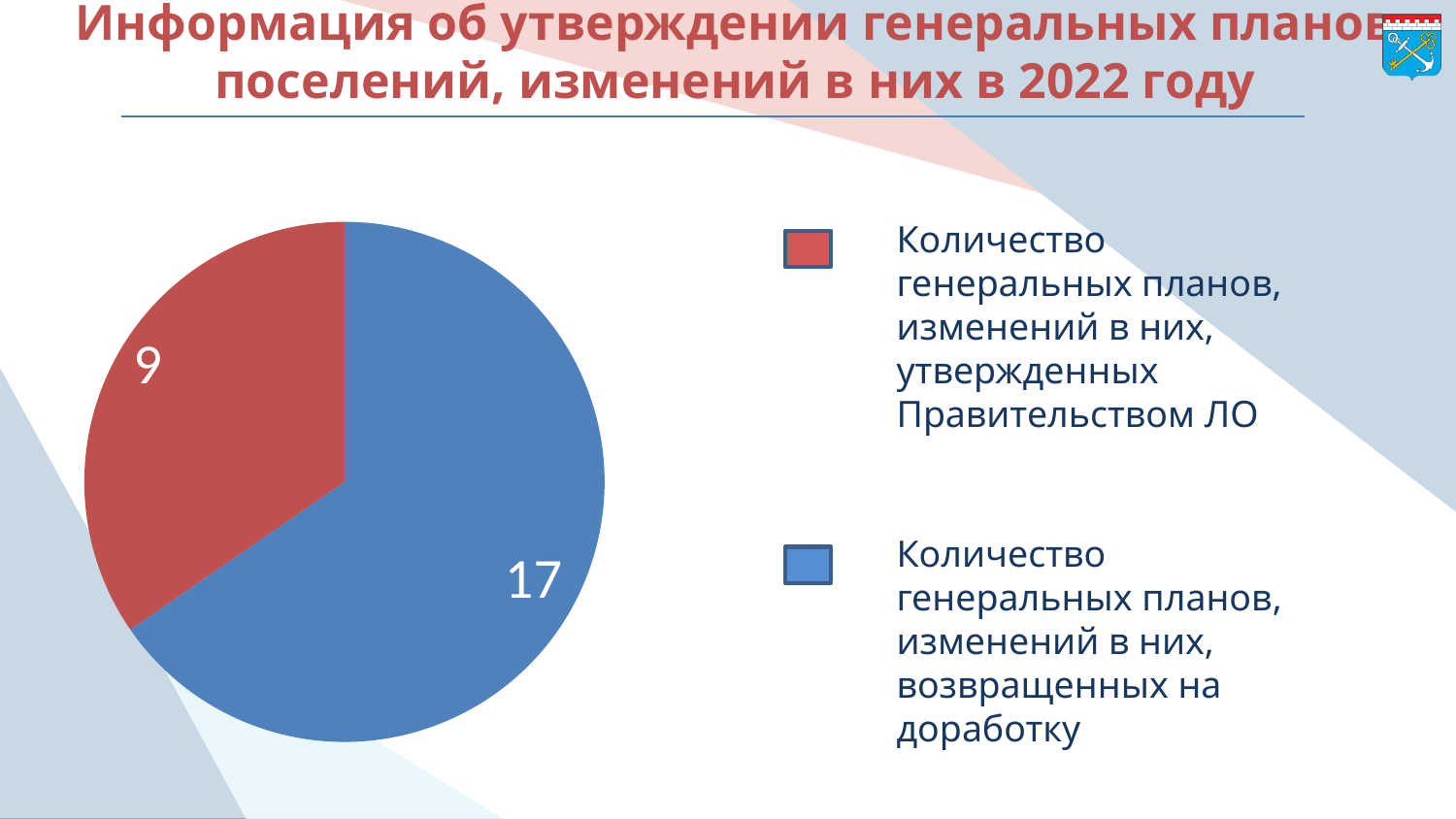
How many slices does the pie chart have? 2 What is the value for the number of general plans and amendments approved by the Government of Leningrad Oblast (Правительством ЛО)? 9 Which category has the smallest slice of the pie? Количество генеральных планов, изменений в них, утвержденных Правительством ЛО What is the total of the two values shown in the pie chart? 26 Which category has the largest slice of the pie? Количество генеральных планов, изменений в них, возвращенных на доработку Which is larger: the number of plans approved by the Government of LO or the number returned for revision? returned for revision (17) What colour is the slice representing plans approved by the Government of LO? red What year does the chart title refer to? 2022 How many entries does the legend list? 2 What is the value for the number of general plans and amendments returned for revision (возвращенных на доработку)? 17 What is the difference between the number of plans returned for revision and the number approved by the Government of LO? 8 What kind of chart is shown on the slide? pie chart